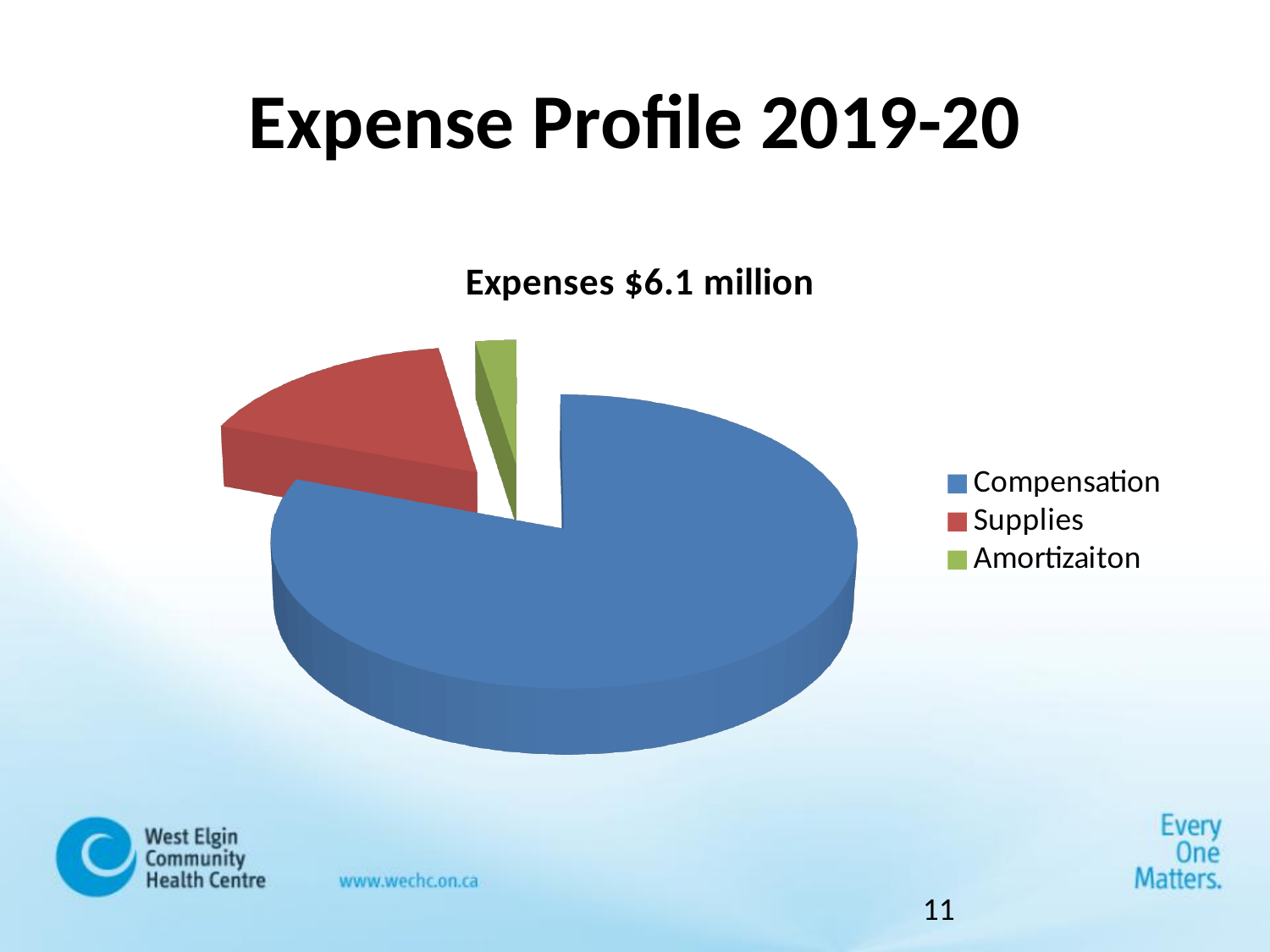
What kind of chart is shown on the slide? pie chart Which category is shown in blue? Compensation Which category has the smallest slice of the pie? Amortizaiton Which category has the largest slice of the pie? Compensation How many slices does the pie chart have? 3 Which is larger, the Supplies slice or the Amortizaiton slice? Supplies What is the title of the chart? Expenses $6.1 million How many entries does the legend list? 3 What colour is the Supplies slice? red Which is larger, the Compensation slice or the Supplies slice? Compensation